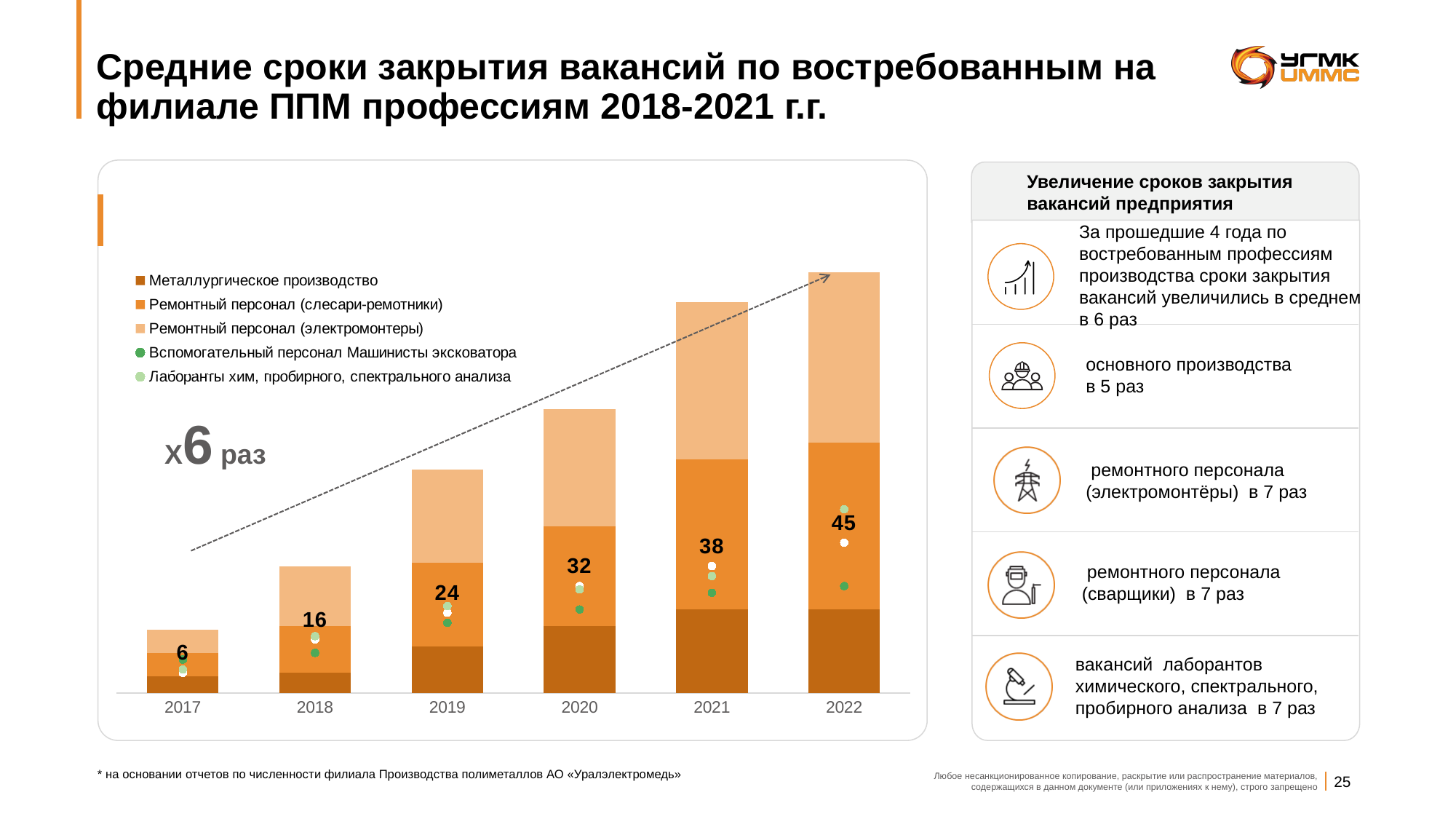
What kind of chart is shown on the slide? stacked bar chart Which year has the tallest stacked bar? 2022 How many years (categories) are shown on the x axis of the chart? 6 Do the bar heights rise or fall from 2017 to 2022? rise What number is printed on the bar for 2017? 6 Which year has the shortest stacked bar? 2017 What multiplier is written in large text inside the chart area? x6 раз What number is printed on the bar for 2022? 45 What is the difference between the numbers printed for 2022 and 2017? 39 What number is printed on the bar for 2021? 38 What number is printed on the bar for 2019? 24 How many series does the chart legend list? 5